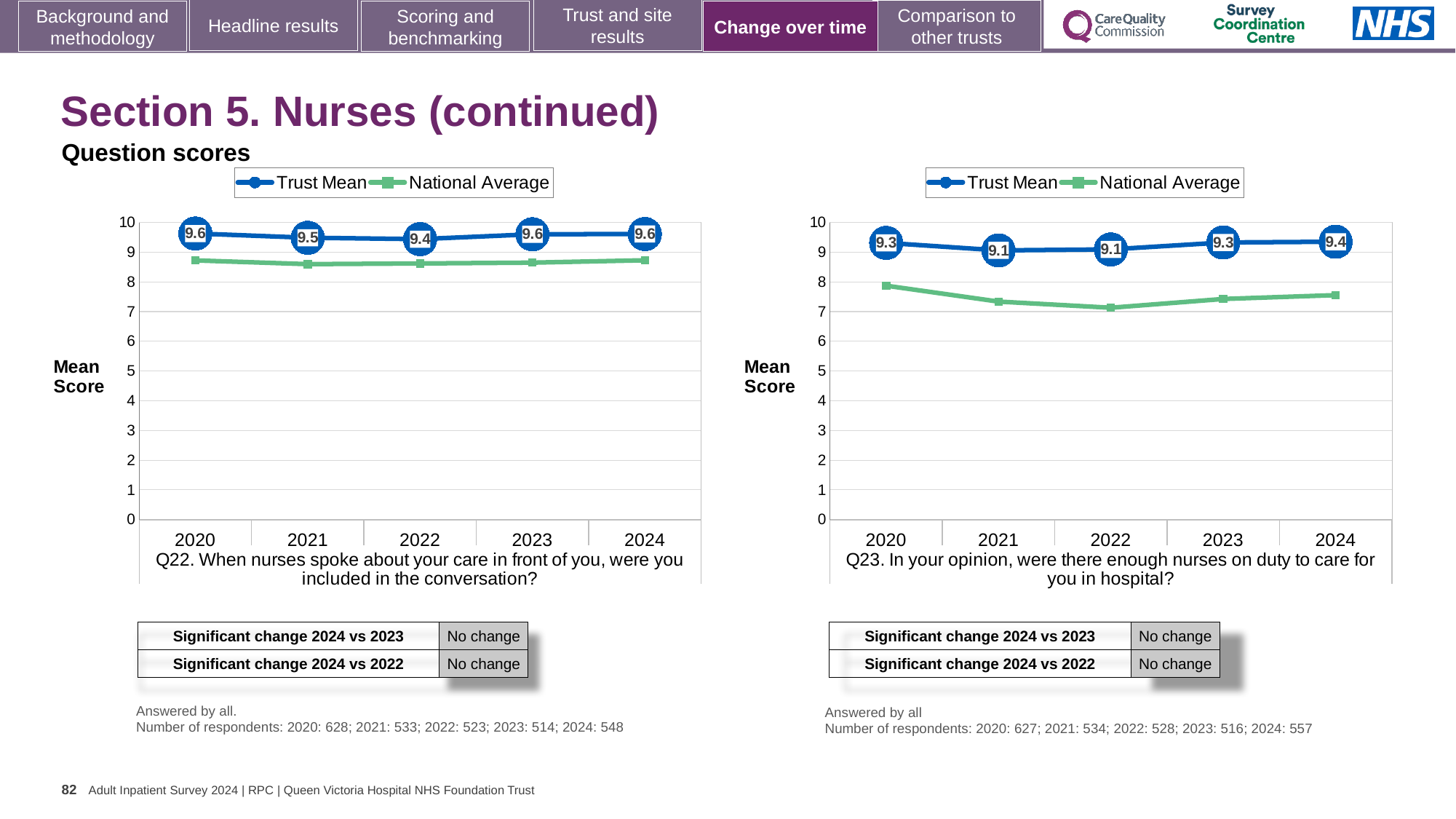
In the Q22 chart on the left, what is the Trust Mean for 2022? 9.4 How many series does the legend of the Q23 chart on the right list? 2 In the Q23 chart on the right, which year has the highest Trust Mean? 2024 In the Q23 chart on the right, is the National Average for 2022 greater or less than 8? less How many years are shown on the x axis of the Q22 chart on the left? 5 In the Q23 chart on the right, what is the Trust Mean for 2024? 9.4 In the Q22 chart on the left, is the National Average for 2020 greater or less than 8? greater In the Q22 chart on the left, which year has the lowest Trust Mean? 2022 In the Q22 chart on the left, is the Trust Mean higher in 2021 or in 2022? 2021 In the Q23 chart on the right, does the Trust Mean rise or fall from 2022 to 2024? Rise In the Q23 chart on the right, what is the difference between the Trust Mean in 2024 and in 2022? 0.3 What type of chart is the Q22 chart on the left? Line chart